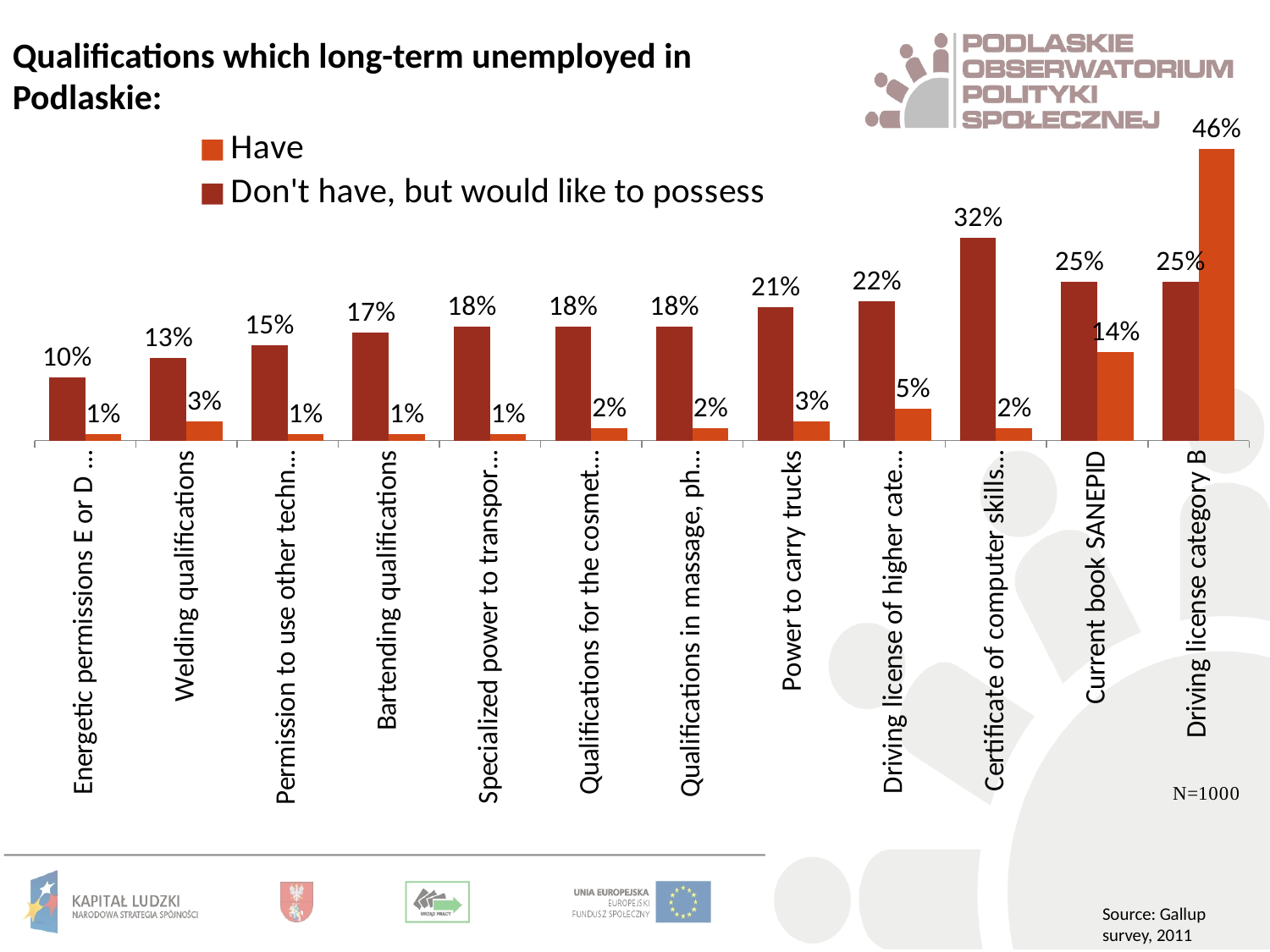
What is the 'Have' value for Current book SANEPID? 14% Which category has the lowest 'Don't have, but would like to possess' value? Energetic permissions E or D What is the 'Don't have, but would like to possess' value for Power to carry trucks? 21% How many qualification categories are plotted on the chart? 12 How many series does the legend list? 2 What is the difference between the 'Have' and 'Don't have, but would like to possess' values for Driving license category B? 21% What is the 'Have' value for Driving license category B? 46% What is the 'Don't have, but would like to possess' value for Welding qualifications? 13% Which category has the highest 'Have' value? Driving license category B What sample size (N) is stated on the slide? N=1000 Which is larger for Bartending qualifications: the 'Have' value or the 'Don't have, but would like to possess' value? Don't have, but would like to possess What kind of chart is shown on the slide? bar chart